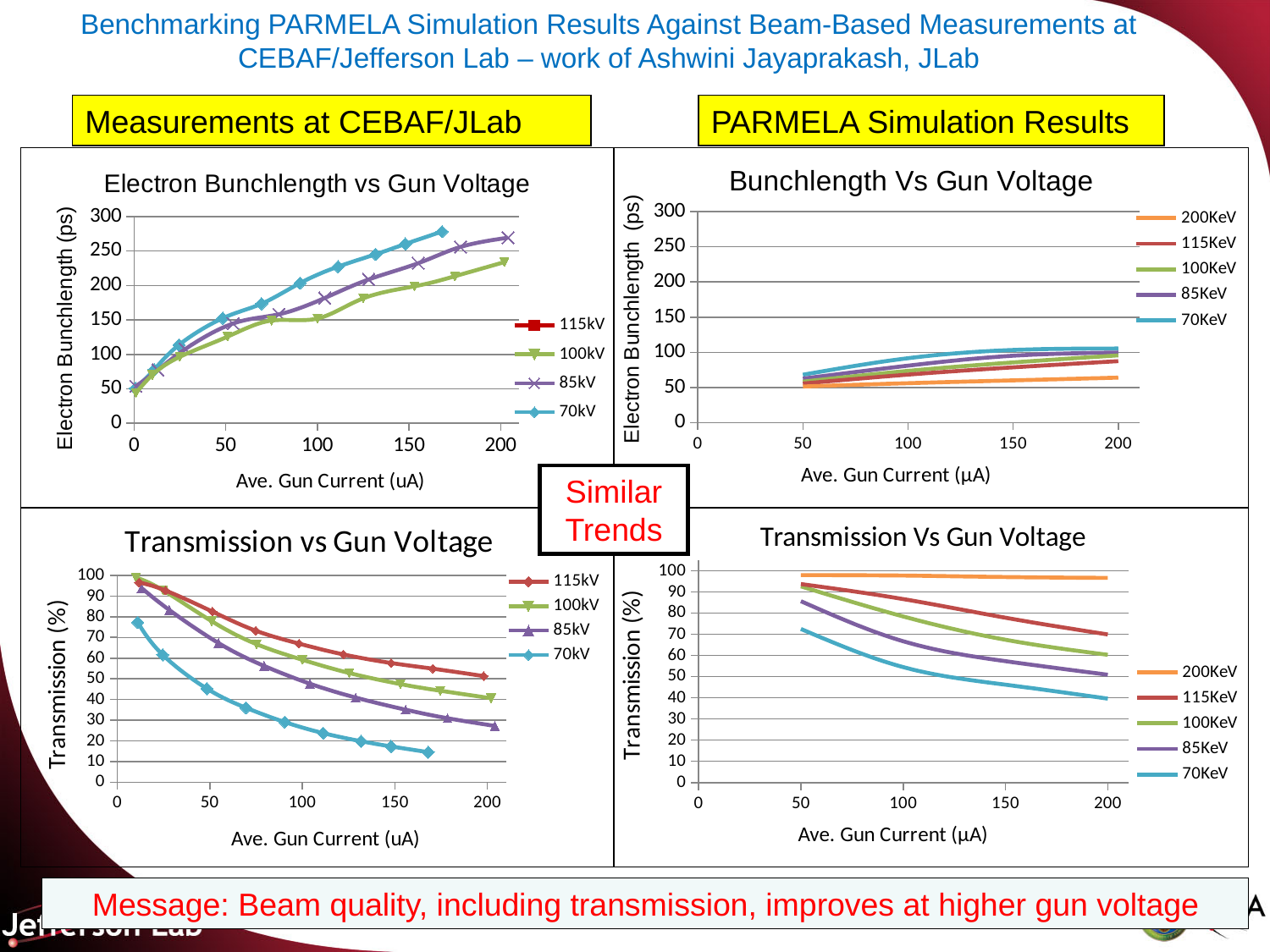
How many series does the legend of the top-right 'Bunchlength Vs Gun Voltage' chart list? 5 In the top-left 'Electron Bunchlength vs Gun Voltage' chart, which series has the highest bunchlength at 150 uA? 70kV In the bottom-left 'Transmission vs Gun Voltage' chart, at 100 uA, which series has the larger transmission: 115kV or 85kV? 115kV In the top-right 'Bunchlength Vs Gun Voltage' chart, is the value for 70KeV at 200 µA greater or less than 150? less In the bottom-left 'Transmission vs Gun Voltage' chart, which series has the lowest transmission at 150 uA? 70kV What is the x-axis label of the bottom-right 'Transmission Vs Gun Voltage' chart? Ave. Gun Current (µA) In the bottom-left 'Transmission vs Gun Voltage' chart, do the transmission values rise or fall as the average gun current increases? fall In the bottom-right 'Transmission Vs Gun Voltage' chart, is the value for 200KeV at 100 µA greater or less than 90? greater In the top-left 'Electron Bunchlength vs Gun Voltage' chart, do the bunchlength values rise or fall as the average gun current increases? rise In the bottom-right 'Transmission Vs Gun Voltage' chart, which series has the highest transmission at 200 µA? 200KeV How many series does the legend of the top-left 'Electron Bunchlength vs Gun Voltage' chart list? 4 What kind of chart is the 'Electron Bunchlength vs Gun Voltage' chart at the top left? line chart